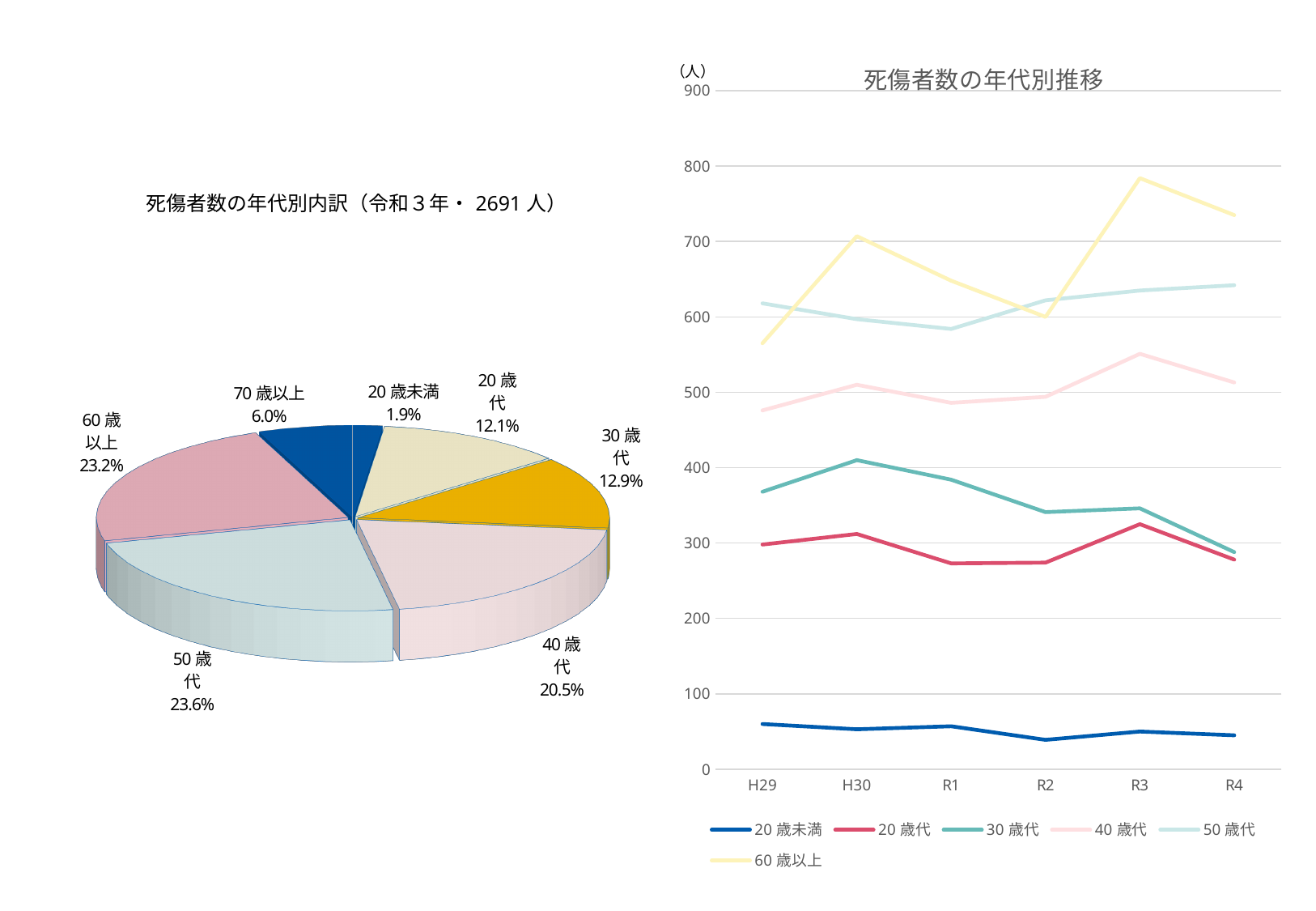
On the line chart 死傷者数の年代別推移, which series has the lowest values across all years? 20歳未満 On the line chart 死傷者数の年代別推移, is the value for 60歳以上 at R3 greater or less than 700? greater On the line chart 死傷者数の年代別推移, how many series does the legend list? 6 On the pie chart 死傷者数の年代別内訳, how many slices are there? 7 On the pie chart 死傷者数の年代別内訳, what share is shown for 20歳未満? 1.9% On the pie chart 死傷者数の年代別内訳, what share is shown for 50歳代? 23.6% On the pie chart 死傷者数の年代別内訳, what is the difference in percentage points between 50歳代 and 40歳代? 3.1% On the pie chart 死傷者数の年代別内訳, which is larger, the share for 20歳代 or for 30歳代? 30歳代 On the pie chart 死傷者数の年代別内訳, which age group has the largest share? 50歳代 On the pie chart 死傷者数の年代別内訳, which age group has the smallest share? 20歳未満 What kind of chart is the chart on the right of the slide? line chart On the line chart 死傷者数の年代別推移, is the value for 20歳未満 at H29 greater or less than 100? less